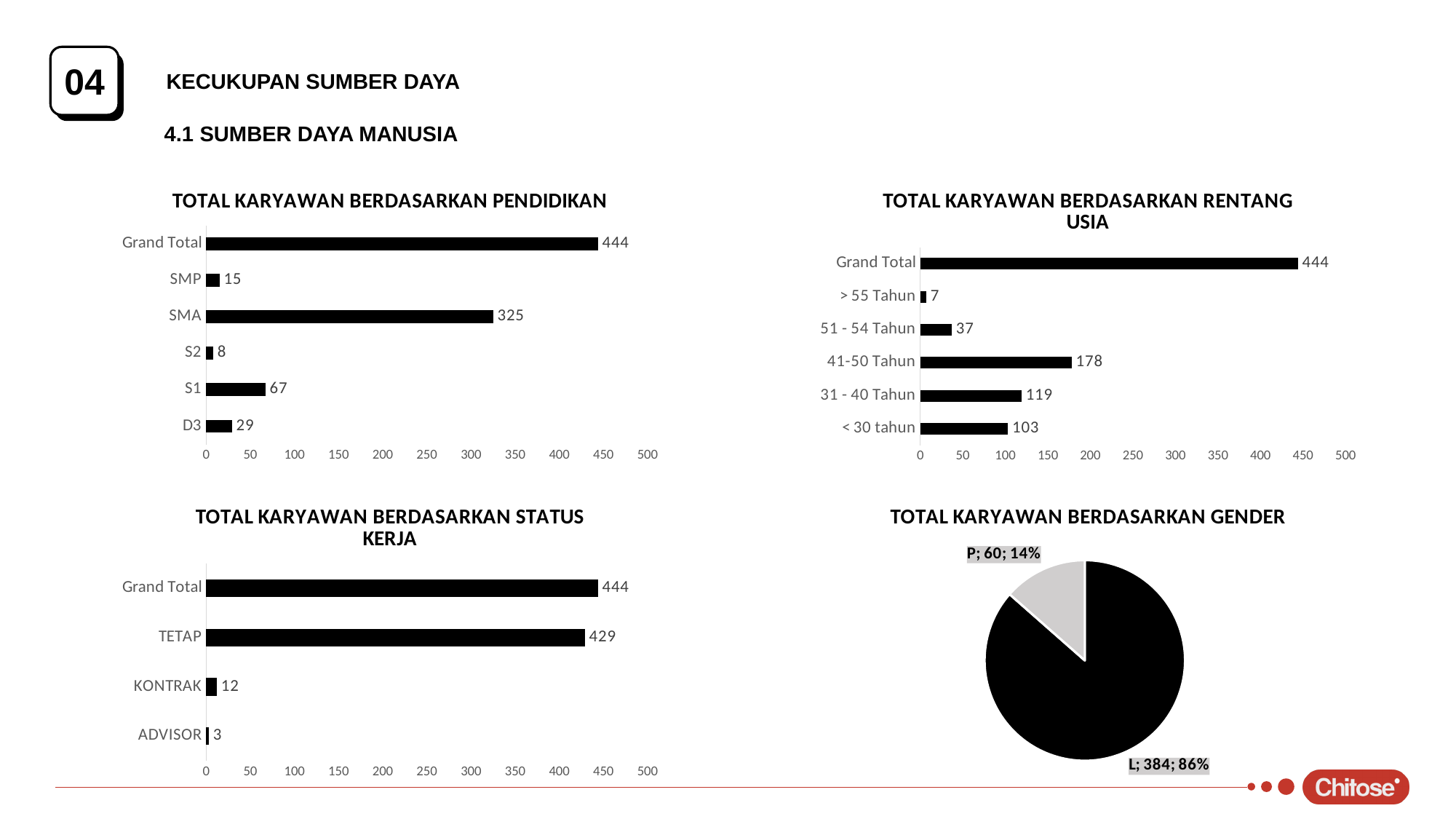
In the chart titled 'TOTAL KARYAWAN BERDASARKAN PENDIDIKAN', what is the value for SMA? 325 What kind of chart is 'TOTAL KARYAWAN BERDASARKAN STATUS KERJA'? Bar chart In the chart titled 'TOTAL KARYAWAN BERDASARKAN PENDIDIKAN', which education category (excluding Grand Total) has the lowest value? S2 In the chart titled 'TOTAL KARYAWAN BERDASARKAN STATUS KERJA', what is the difference between the values for TETAP and KONTRAK? 417 In the chart titled 'TOTAL KARYAWAN BERDASARKAN STATUS KERJA', what is the value for KONTRAK? 12 In the chart titled 'TOTAL KARYAWAN BERDASARKAN RENTANG USIA', which is larger: the value for 31 - 40 Tahun or the value for < 30 tahun? 31 - 40 Tahun In the chart titled 'TOTAL KARYAWAN BERDASARKAN RENTANG USIA', what is the value for 41-50 Tahun? 178 In the chart titled 'TOTAL KARYAWAN BERDASARKAN RENTANG USIA', which age range has the highest value (excluding Grand Total)? 41-50 Tahun In the chart titled 'TOTAL KARYAWAN BERDASARKAN GENDER', what is the value for P? 60 In the chart titled 'TOTAL KARYAWAN BERDASARKAN RENTANG USIA', how many bars are plotted, including Grand Total? 6 In the chart titled 'TOTAL KARYAWAN BERDASARKAN GENDER', what share of the pie does the L slice represent? 86% In the chart titled 'TOTAL KARYAWAN BERDASARKAN PENDIDIKAN', what is the difference between the values for S1 and D3? 38